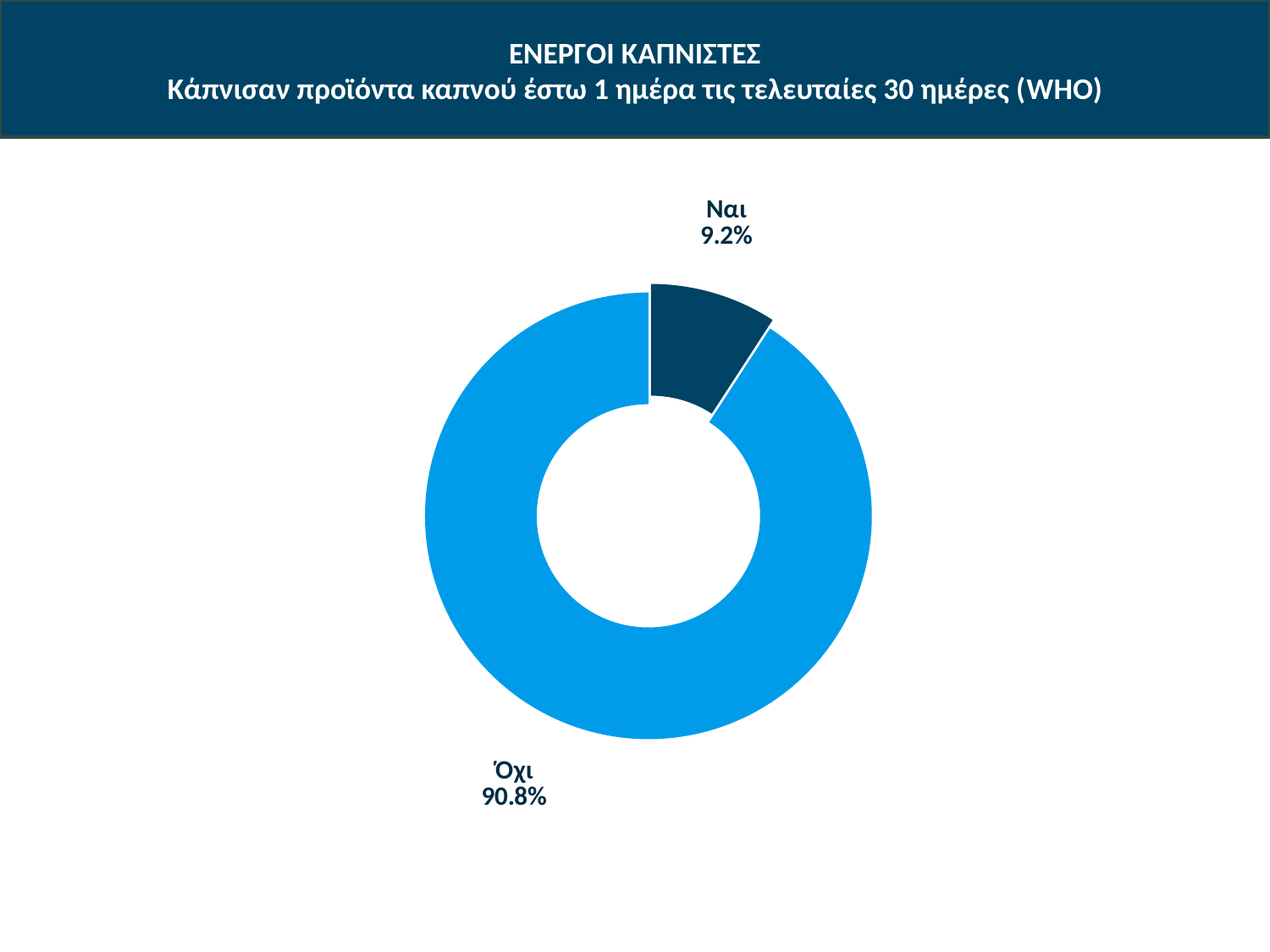
What is the difference in percentage points between the "Όχι" and "Ναι" slices? 81.6 What colour is the "Ναι" slice? Dark blue What is the first line of the chart's title? ΕΝΕΡΓΟΙ ΚΑΠΝΙΣΤΕΣ What share of the chart does the "Ναι" slice represent? 9.2% Which is larger, the "Ναι" slice or the "Όχι" slice? Όχι How many categories are shown in the chart? 2 What percentage is shown for the "Όχι" slice? 90.8% What percentage is shown for the "Ναι" slice? 9.2% Which category has the largest share of the chart? Όχι What kind of chart is shown on the slide? Pie chart (doughnut) What is the total of the two slices shown? 100% Which category has the smallest share of the chart? Ναι